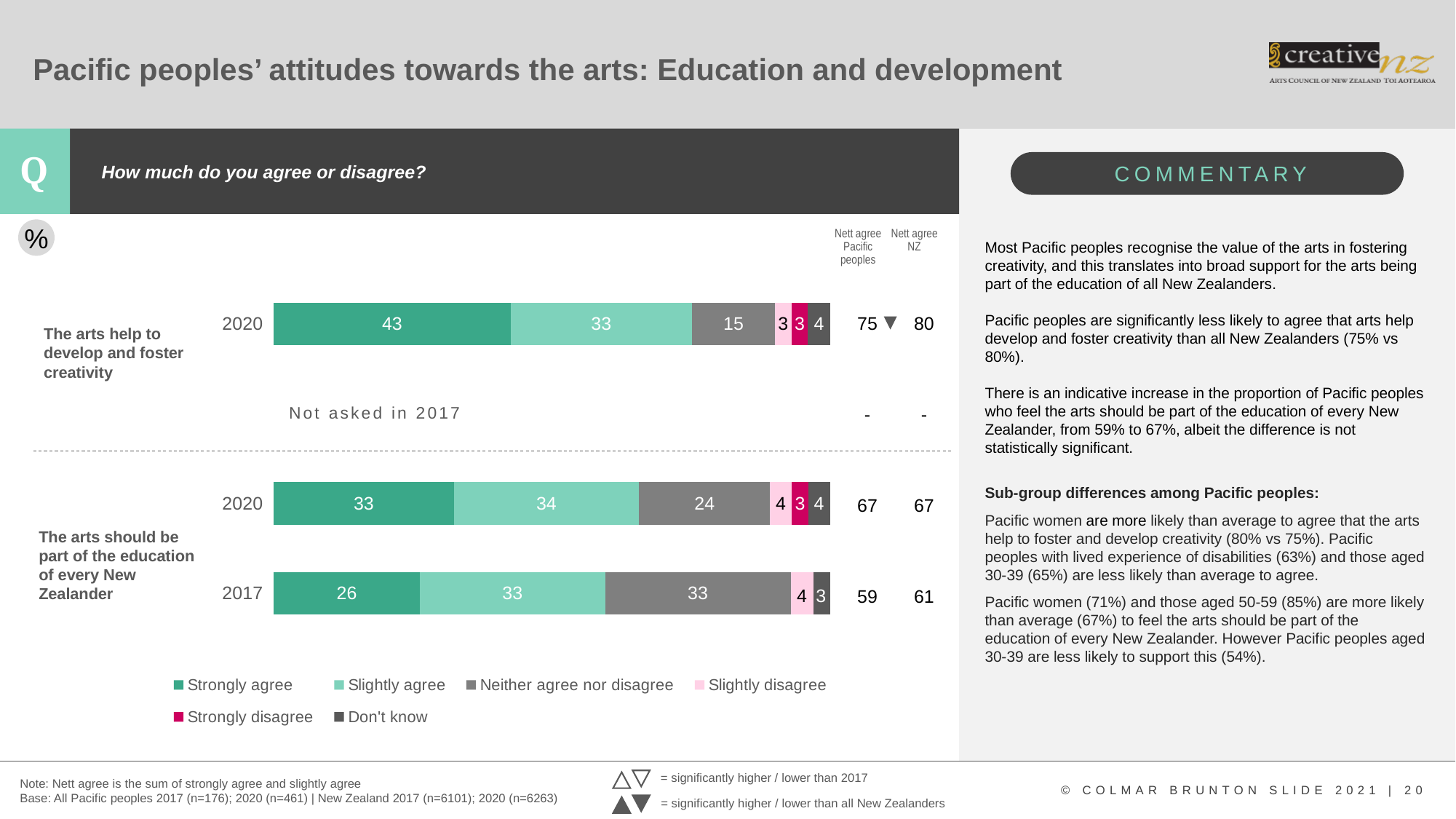
What is the Nett agree value for Pacific peoples for 'The arts help to develop and foster creativity' in 2020? 75 How did the Nett agree value for Pacific peoples for 'The arts should be part of the education of every New Zealander' change from 2017 to 2020? It rose from 59 to 67 What is the 'Slightly agree' value for 'The arts should be part of the education of every New Zealander' in 2020? 34 What kind of chart is shown on the slide? Stacked bar chart Which bar has the highest 'Strongly agree' value? The arts help to develop and foster creativity, 2020 What is the 'Strongly agree' value for 'The arts help to develop and foster creativity' in 2020? 43 What is the Nett agree NZ value for 'The arts should be part of the education of every New Zealander' in 2017? 61 Which legend entry is shown in dark pink? Strongly disagree Which is larger: the 'Neither agree nor disagree' value for 'The arts help to develop and foster creativity' in 2020 or for 'The arts should be part of the education of every New Zealander' in 2020? The arts should be part of the education of every New Zealander (2020) What is the difference between the 'Strongly agree' values for 'The arts should be part of the education of every New Zealander' in 2020 and 2017? 7 How many series does the legend list? 6 What is the 'Neither agree nor disagree' value for 'The arts should be part of the education of every New Zealander' in 2017? 33